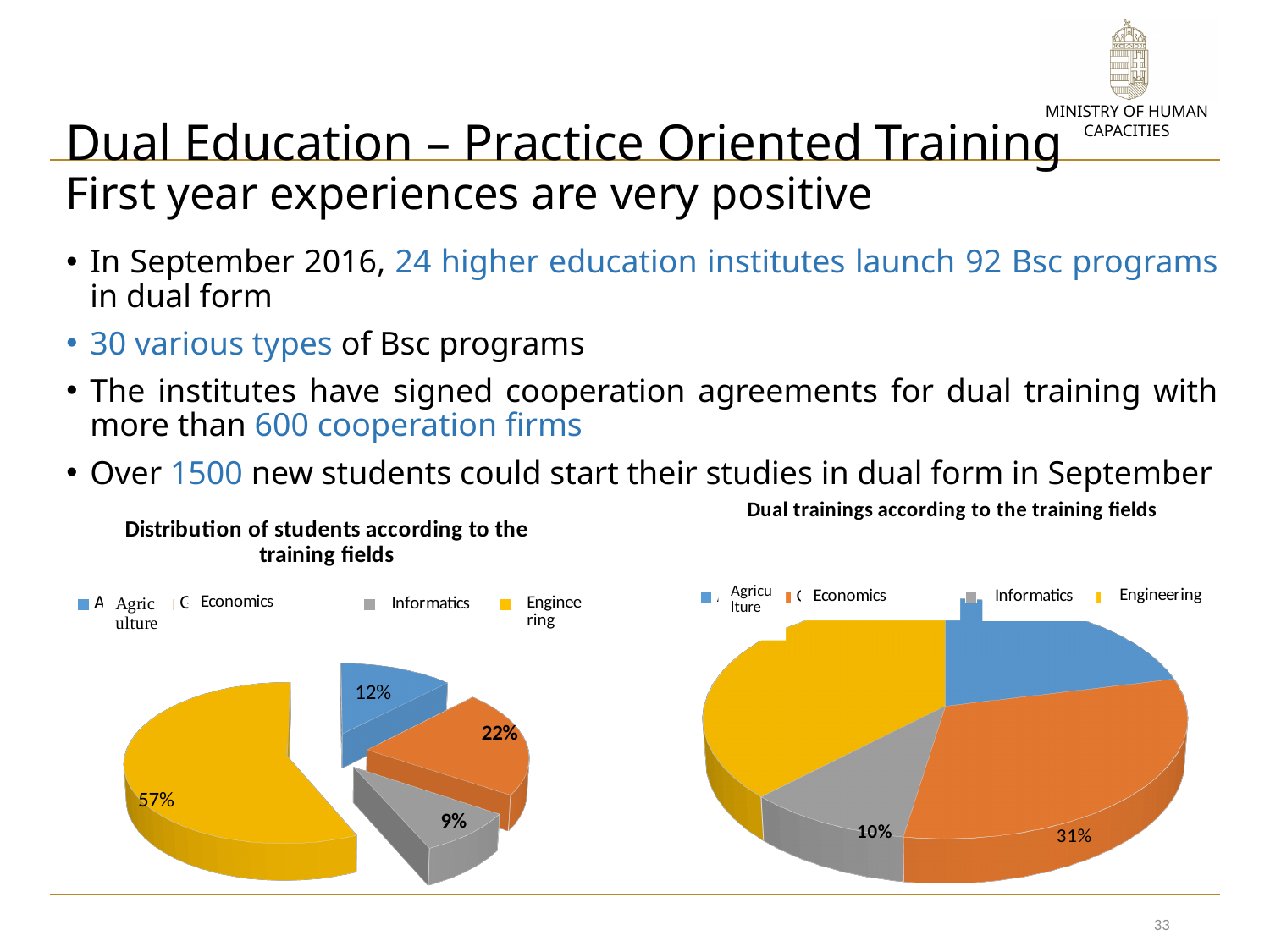
In the chart titled "Distribution of students according to the training fields", what share of students is in Informatics? 9% In the chart titled "Distribution of students according to the training fields", which training field has the smallest share? Informatics In the chart titled "Distribution of students according to the training fields", what share of students is in Agriculture? 12% What kind of chart is the chart titled "Dual trainings according to the training fields"? Pie chart In the chart titled "Distribution of students according to the training fields", which training field has the largest share? Engineering How many training fields does the legend of the chart titled "Distribution of students according to the training fields" list? 4 In the chart titled "Distribution of students according to the training fields", what share of students is in Economics? 22% In the chart titled "Distribution of students according to the training fields", what is the difference in percentage points between Engineering and Economics? 35 In the chart titled "Distribution of students according to the training fields", what share of students is in Engineering? 57% In the chart titled "Dual trainings according to the training fields", which training field has the largest share? Engineering In the chart titled "Dual trainings according to the training fields", what share is Informatics? 10% In the chart titled "Dual trainings according to the training fields", what share is Economics? 31%